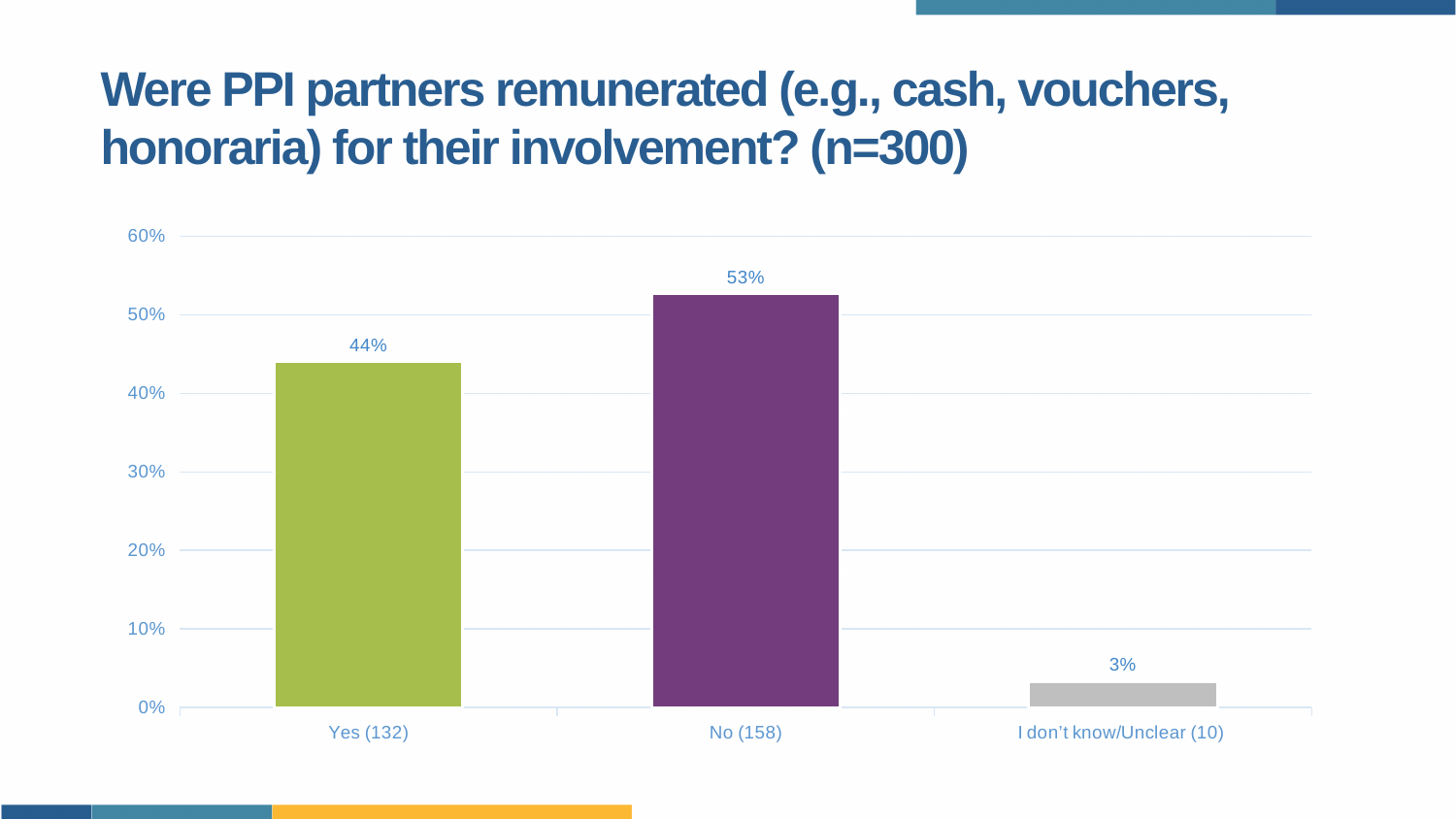
What colour is the bar for 'No (158)'? Purple Is the value for 'Yes (132)' greater or less than 50%? less How many categories are shown on the chart? 3 Which category has the highest percentage? No (158) What is the difference in percentage points between 'No (158)' and 'Yes (132)'? 9% Which is larger, the percentage for 'Yes (132)' or for 'No (158)'? No (158) What percentage of responses were 'I don't know/Unclear (10)'? 3% What percentage of responses were 'No (158)'? 53% Which category has the lowest percentage? I don't know/Unclear (10) What percentage of responses were 'Yes (132)'? 44% What is the highest value shown on the y axis? 60% What kind of chart is shown on the slide? Bar chart